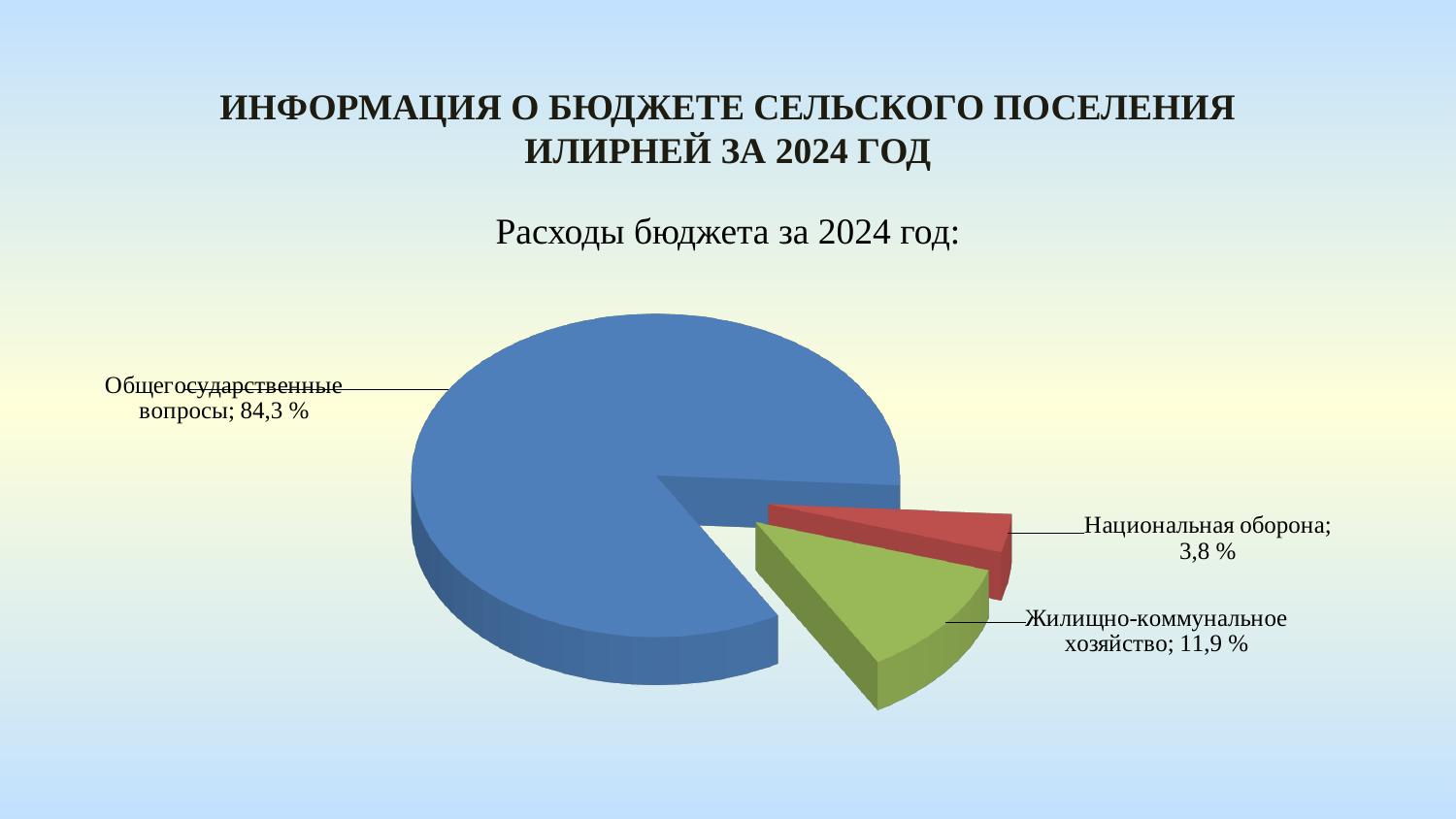
What is the title of the chart? Расходы бюджета за 2024 год: What kind of chart is shown on the slide? Pie chart What is the difference in percentage points between Жилищно-коммунальное хозяйство and Национальная оборона? 8,1 What is the difference in percentage points between Общегосударственные вопросы and Жилищно-коммунальное хозяйство? 72,4 What value is shown for Национальная оборона? 3,8 % How many categories are shown in the pie chart? 3 Which is larger, Жилищно-коммунальное хозяйство or Национальная оборона? Жилищно-коммунальное хозяйство Which category has the largest slice of the pie? Общегосударственные вопросы What value is shown for Жилищно-коммунальное хозяйство? 11,9 % What colour is the slice for Национальная оборона? Red What share of the pie does Общегосударственные вопросы have? 84,3 % Which category has the smallest slice of the pie? Национальная оборона